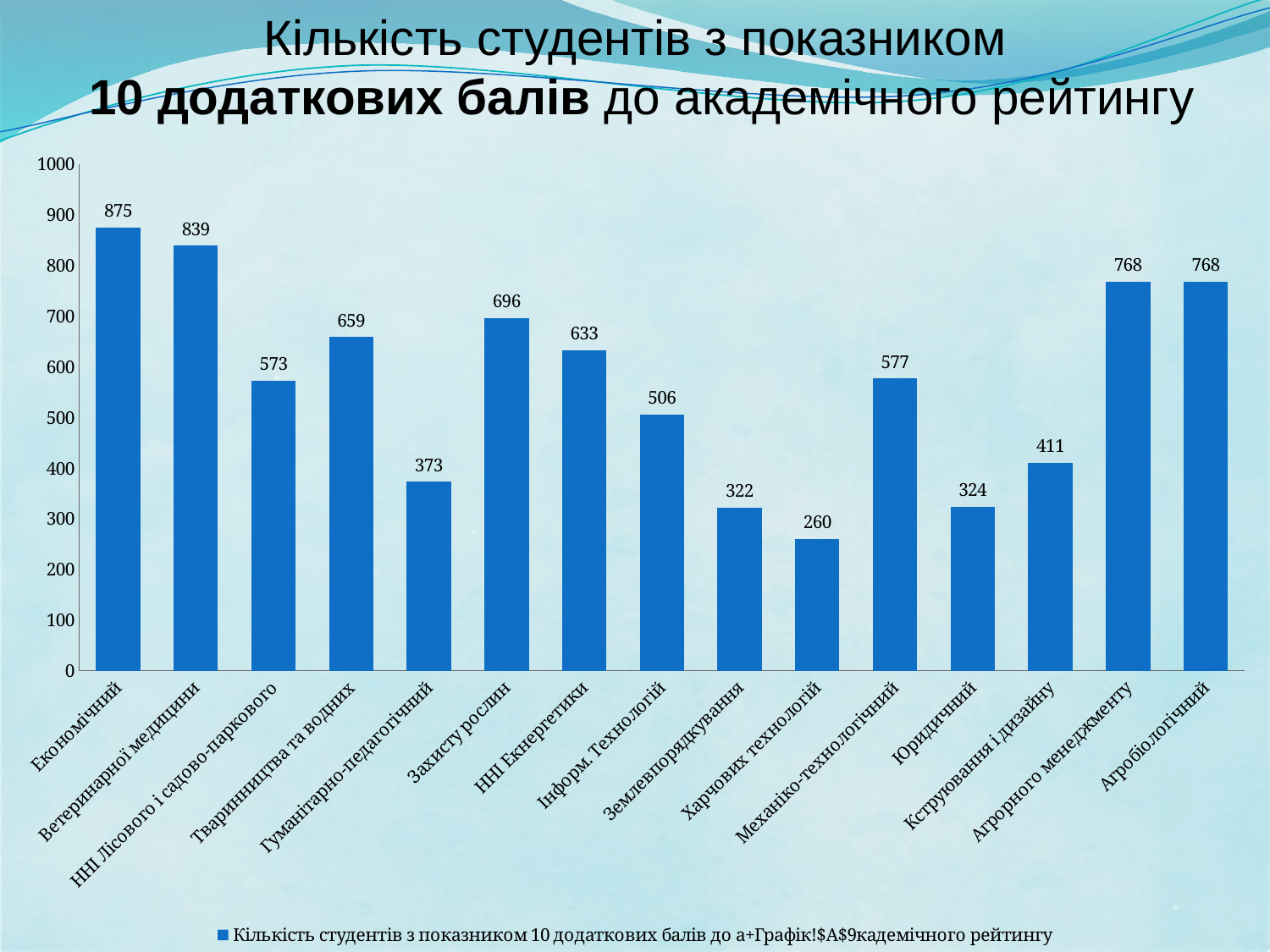
What is the difference between the values for Економічний and Ветеринарної медицини? 36 What is the value for Юридичний? 324 How many categories are shown on the x axis? 15 Which category has the lowest value? Харчових технологій What is the difference between the values for Механіко-технологічний and Інформ. Технологій? 71 Which is larger, the value for Тваринництва та водних or the value for ННІ Екнергетики? Тваринництва та водних Is the value for Гуманітарно-педагогічний greater or less than 400? less What is the value for Захисту рослин? 696 What is the value for Економічний? 875 What kind of chart is shown on the slide? bar chart Which category has the highest value? Економічний How many series does the legend list? 1